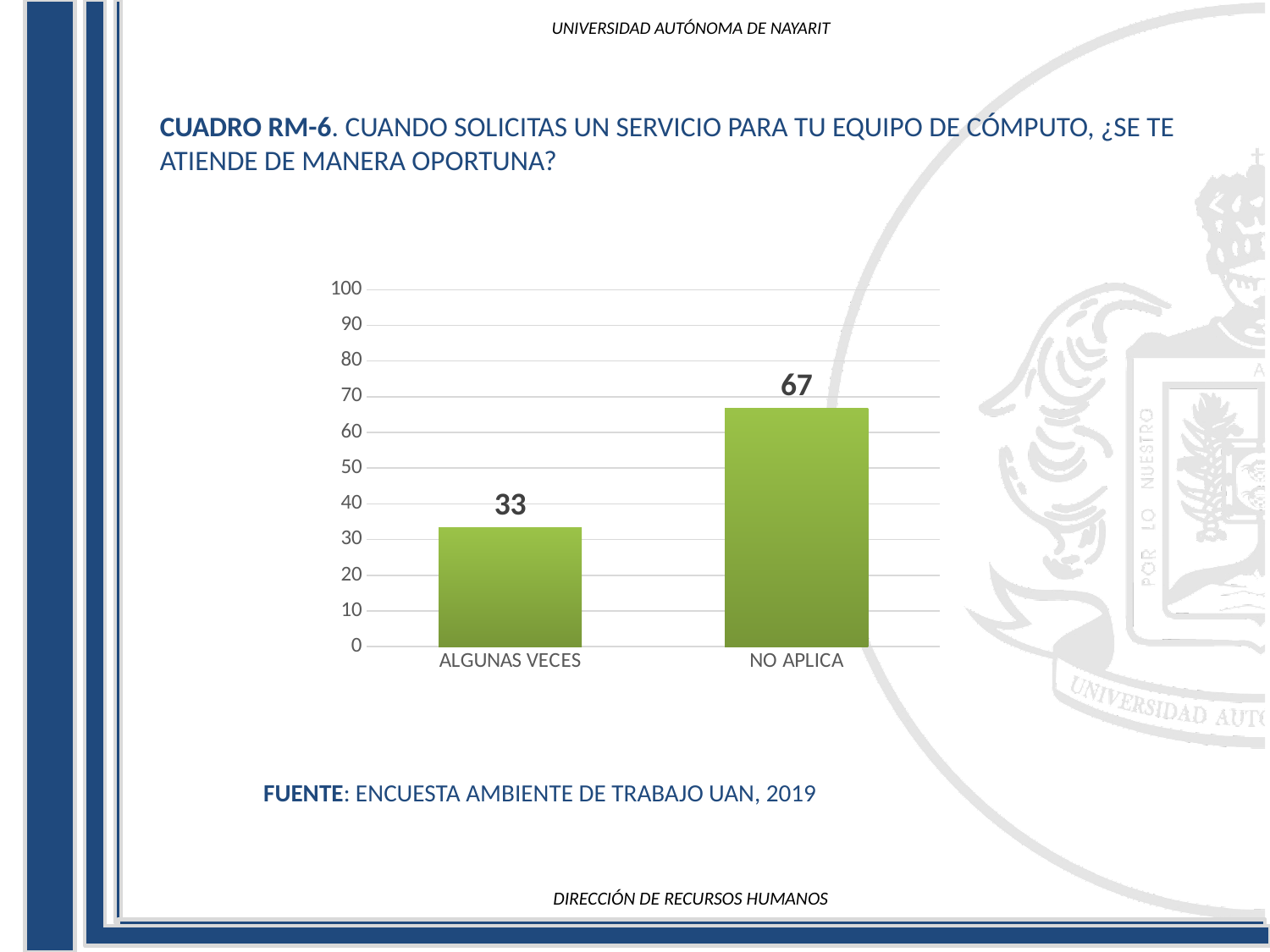
Is the value for ALGUNAS VECES greater or less than 40? less Which category has the lowest value? ALGUNAS VECES What is the total of the two values shown on the chart? 100 Which is larger, the value for ALGUNAS VECES or the value for NO APLICA? NO APLICA How many categories are shown on the chart? 2 What is the source cited below the chart? ENCUESTA AMBIENTE DE TRABAJO UAN, 2019 What is the difference between the values for NO APLICA and ALGUNAS VECES? 34 What kind of chart is shown on the slide? bar chart What is the value for ALGUNAS VECES? 33 What is the value for NO APLICA? 67 Is the value for NO APLICA greater or less than 50? greater Which category has the highest value? NO APLICA